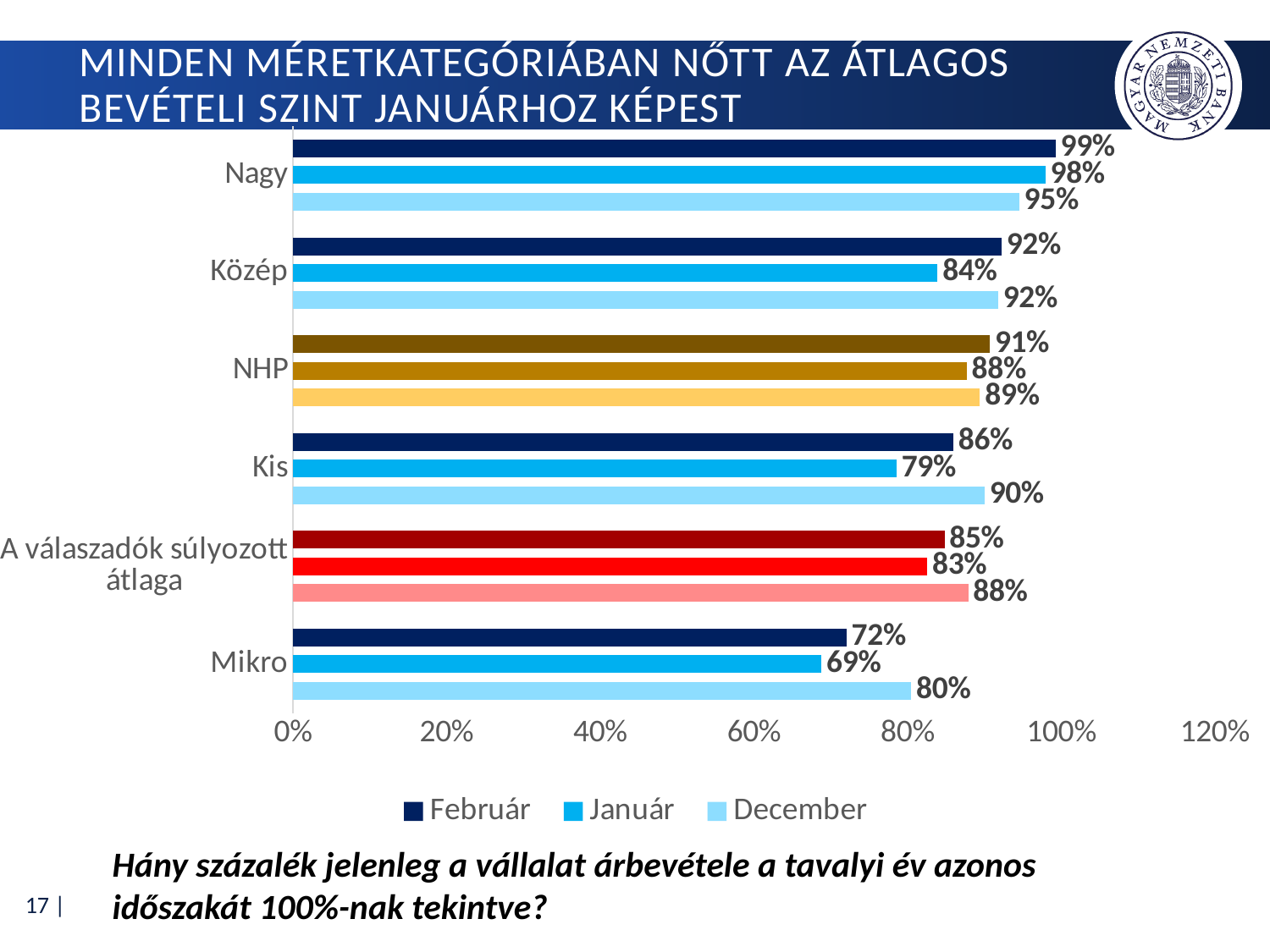
What is the Január value for Közép? 84% Which category has the lowest Január value? Mikro Which is larger for NHP: the Január value or the December value? December What is the Február value for Nagy? 99% Which category has the highest Február value? Nagy How many series does the legend list? 3 What is the December value for Mikro? 80% What is the difference between the Február and Január values for Kis? 7% What kind of chart is shown on the slide? Bar chart How many categories are shown on the chart? 6 What are the three series listed in the legend? Február, Január, December What is the Január value for Kis? 79%